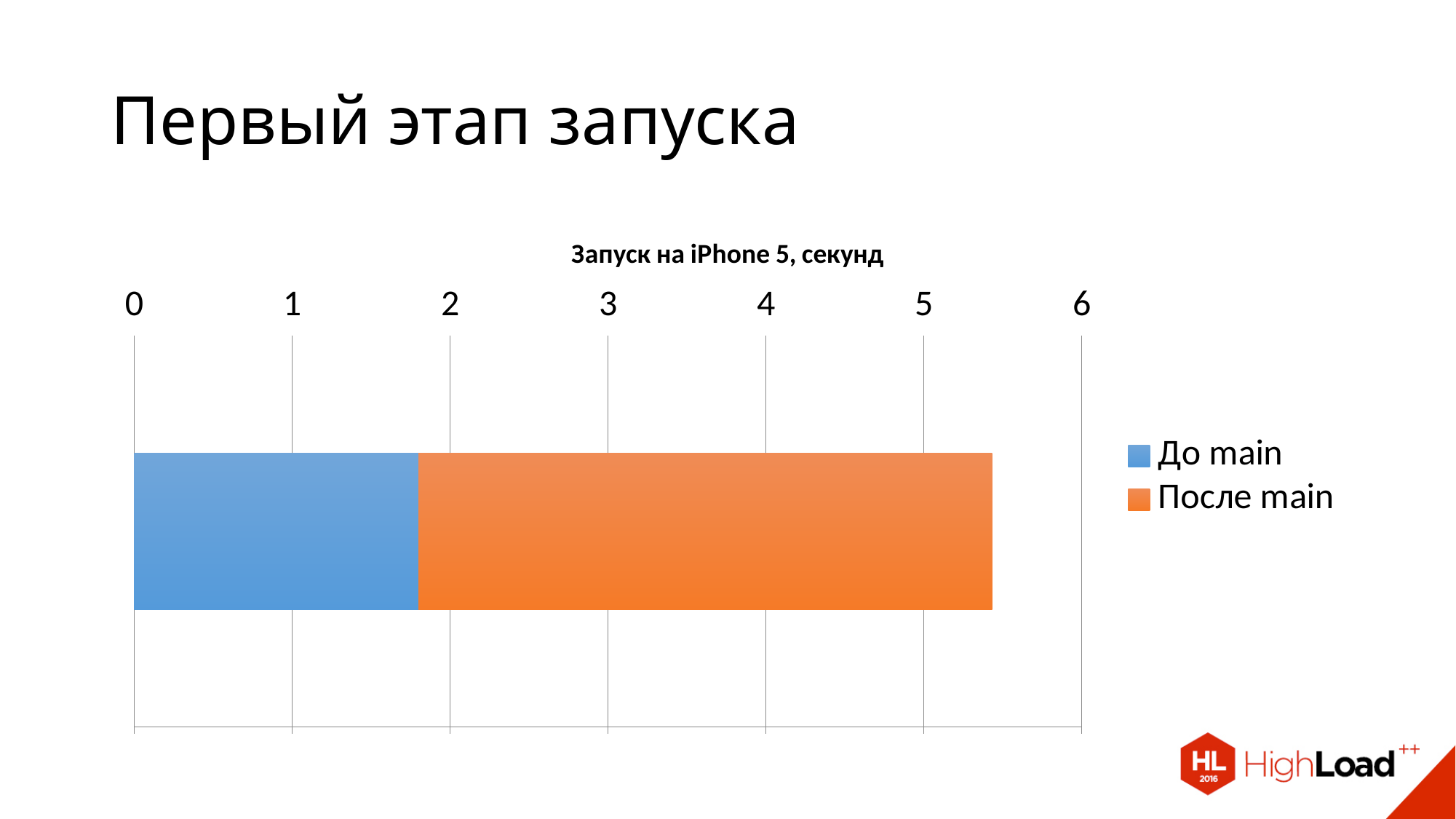
Is the value for После main greater or less than 3? greater Which series takes up the larger part of the bar, До main or После main? После main Which series is shown in orange in the legend? После main What is the title of the chart? Запуск на iPhone 5, секунд How many bars are plotted in the chart? 1 Is the total length of the stacked bar greater or less than 5? greater What is the highest value shown on the horizontal axis? 6 Is the value for До main greater or less than 2? less How many series does the legend list? 2 What kind of chart is shown on the slide? bar chart